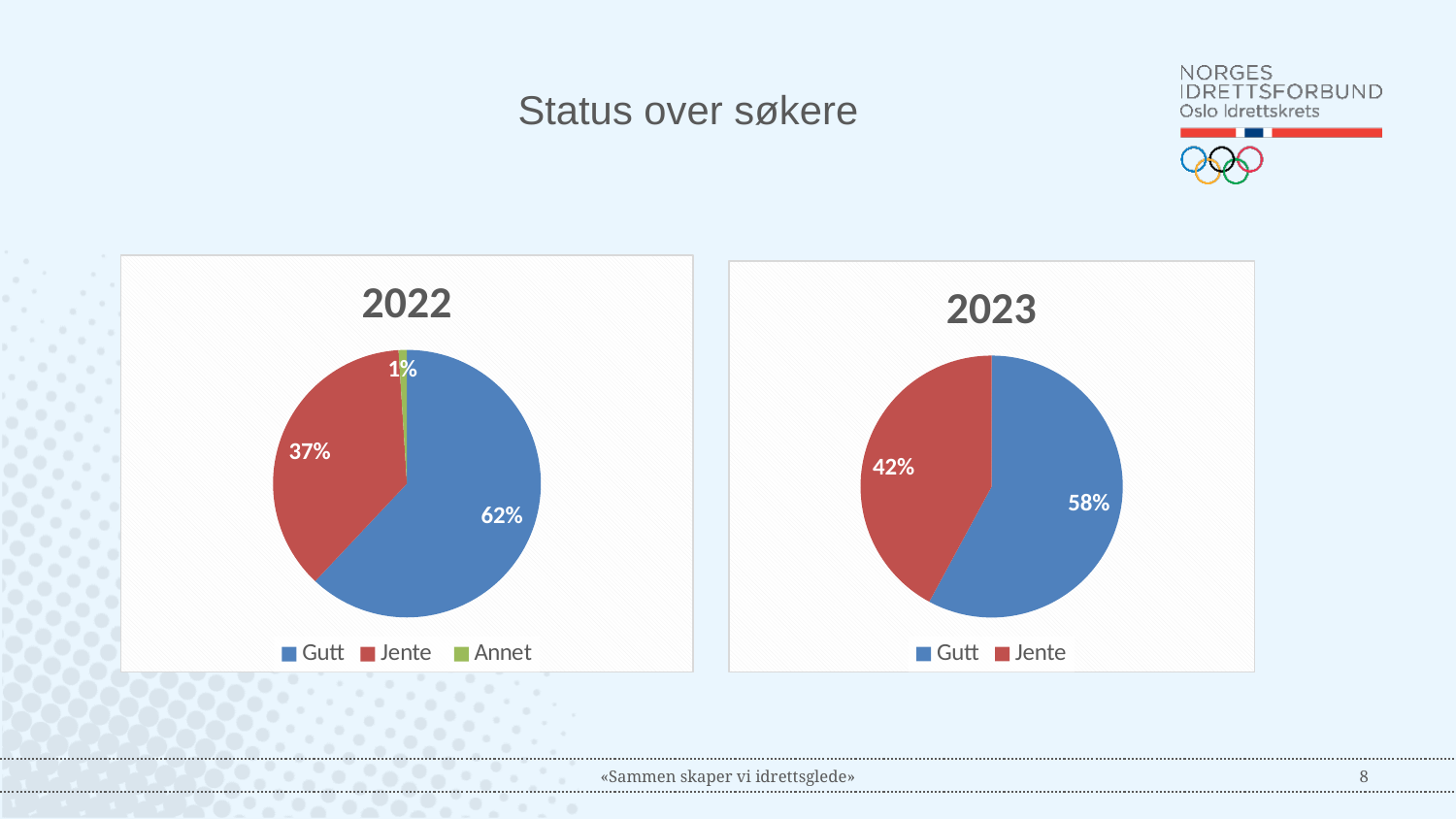
What kind of chart is the 2023 chart? Pie chart In the 2023 chart, what is the difference between the Gutt and Jente shares? 16% In the 2022 chart, how many categories does the legend list? 3 In the 2022 chart, what share of the pie is Gutt? 62% In the 2022 chart, what share of the pie is Annet? 1% In the 2022 chart, what share of the pie is Jente? 37% In the 2023 chart, which category has the smaller slice? Jente In the 2022 chart, which category has the smallest slice? Annet In the 2023 chart, how many categories does the legend list? 2 In the 2022 chart, which category has the largest slice? Gutt